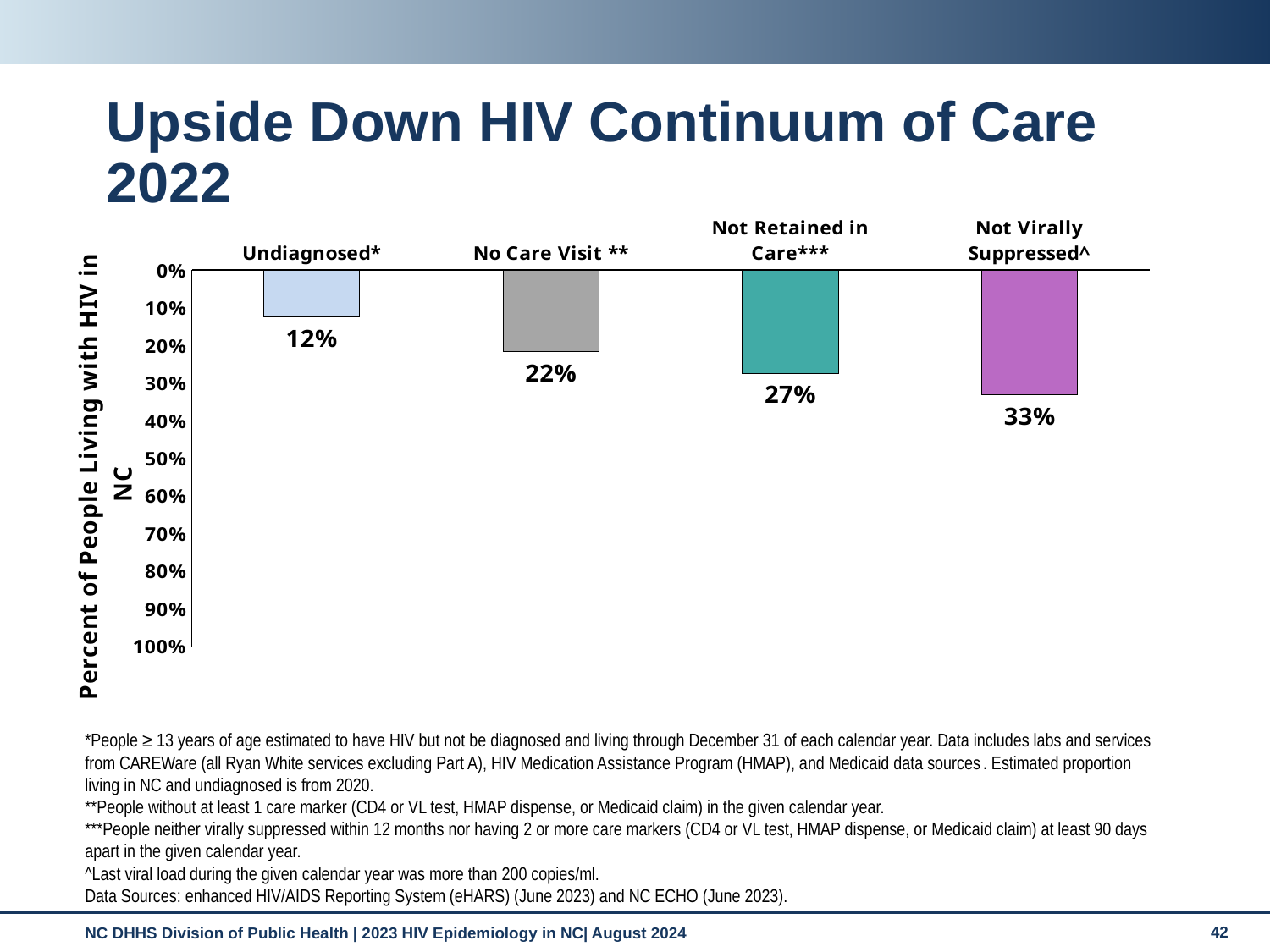
Which category has the lowest value? Undiagnosed* How many categories are shown in the chart? 4 What is the difference between the values for Not Virally Suppressed^ and Undiagnosed*? 21% What is the difference between the values for Not Retained in Care*** and No Care Visit **? 5% What is the value for Not Virally Suppressed^? 33% What is the value for Undiagnosed*? 12% Which category has the highest value? Not Virally Suppressed^ What is the value for No Care Visit **? 22% What is the value for Not Retained in Care***? 27% What kind of chart is shown on the slide? Bar chart Do the values rise or fall from left to right across the categories? Rise Which is larger, the value for No Care Visit ** or the value for Not Retained in Care***? Not Retained in Care***